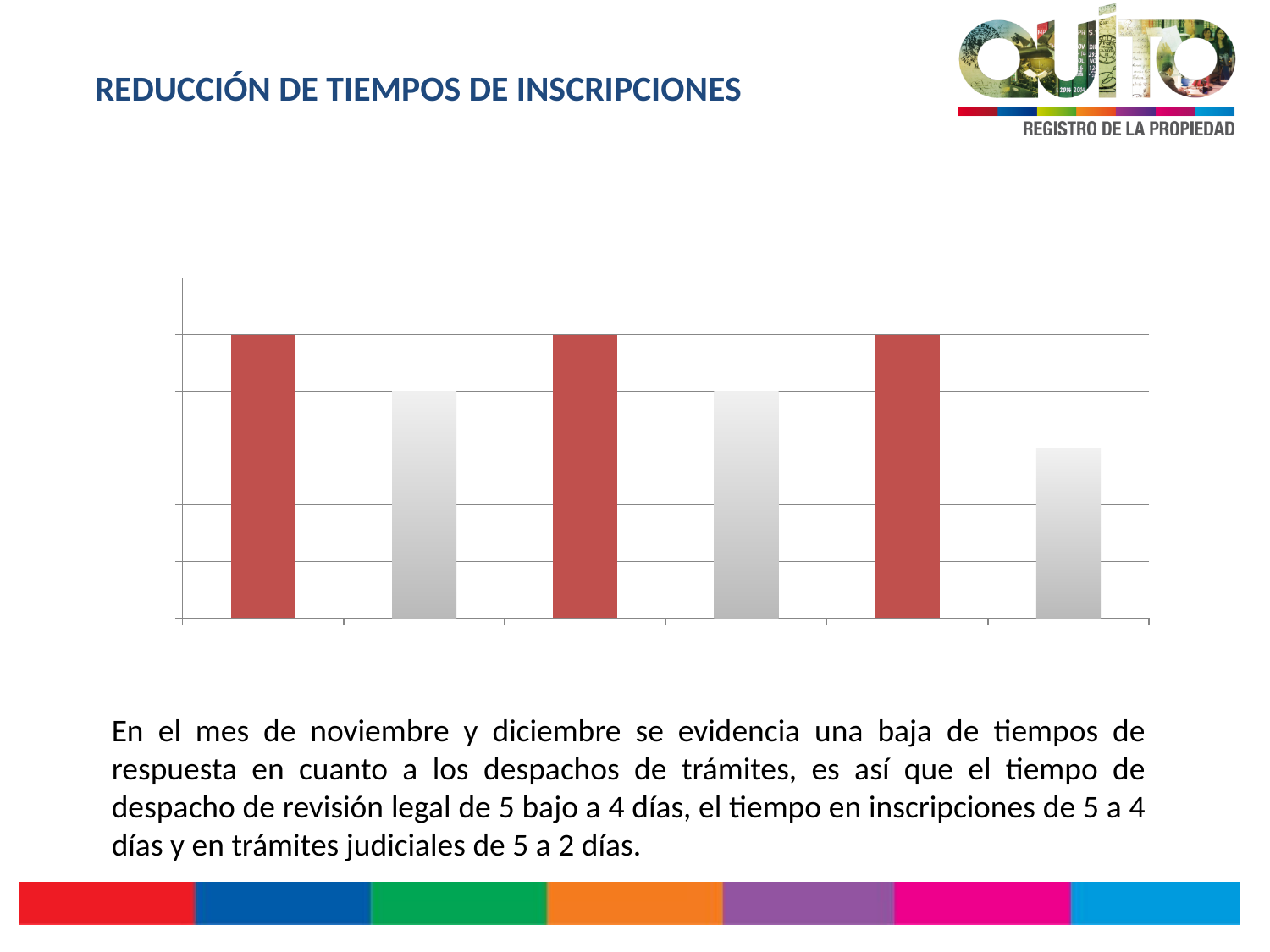
How many bars are plotted in the chart? 6 Are the second and fourth bars from the left the same height or different heights? the same height What kind of chart is shown on the slide? bar chart Is the fifth bar from the left taller or shorter than the sixth bar? taller Is the third bar from the left taller or shorter than the fourth bar? taller What is the title shown at the top of the slide? REDUCCIÓN DE TIEMPOS DE INSCRIPCIONES What colour are the first, third and fifth bars in the chart? red Which bar in the chart is the shortest, counting from the left? the sixth bar